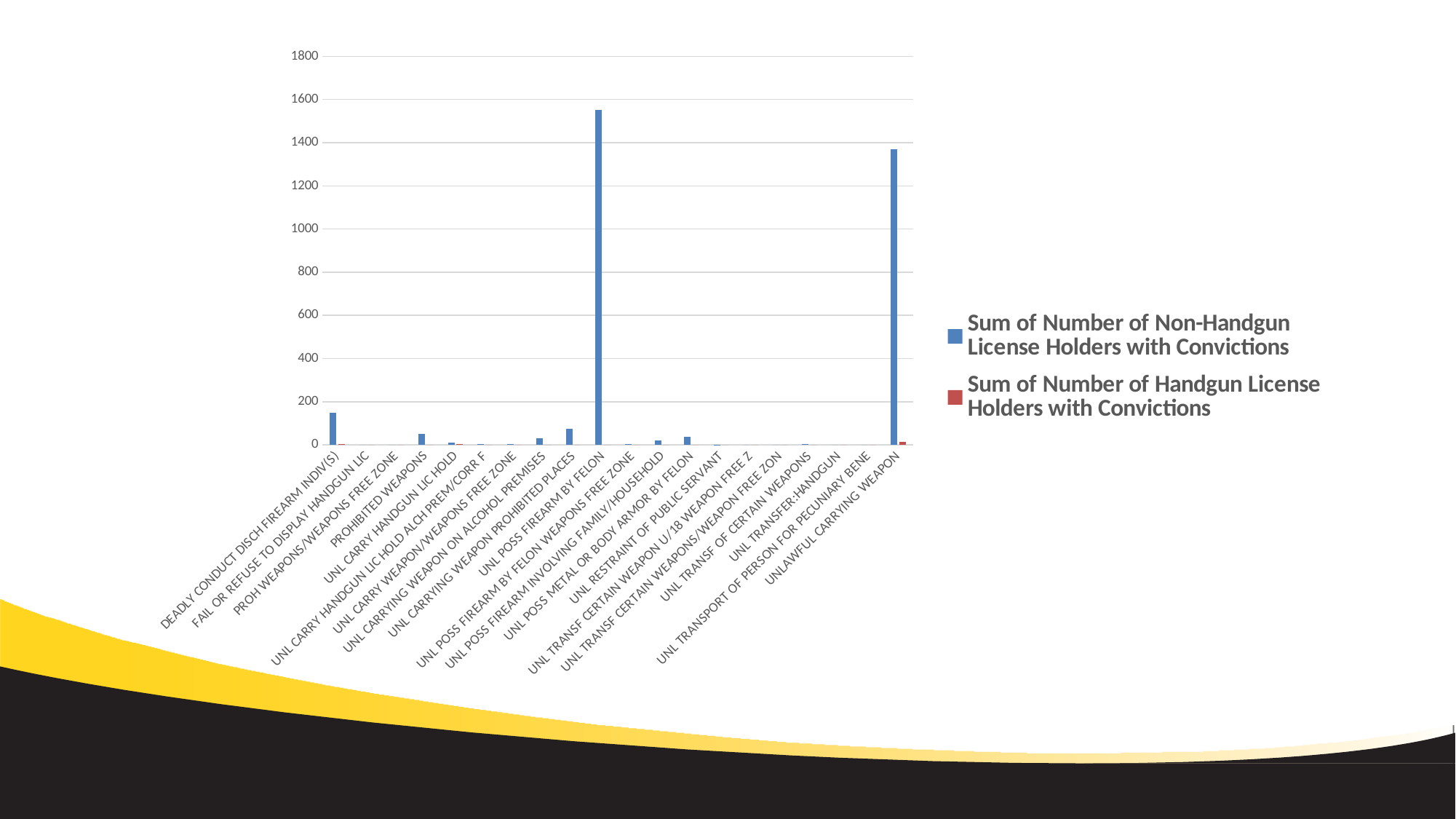
Is the value for UNLAWFUL CARRYING WEAPON in the Non-Handgun License Holders series greater or less than 1200? greater What kind of chart is shown on the slide? bar chart How many categories are shown on the x axis? 20 Which is larger for Non-Handgun License Holders with Convictions: DEADLY CONDUCT DISCH FIREARM INDIV(S) or PROHIBITED WEAPONS? DEADLY CONDUCT DISCH FIREARM INDIV(S) Which category has the highest value for Sum of Number of Non-Handgun License Holders with Convictions? UNL POSS FIREARM BY FELON How many series does the legend list? 2 Is the value for UNLAWFUL CARRYING WEAPON in the Non-Handgun License Holders series greater or less than 1400? less Is the value for UNL POSS FIREARM BY FELON in the Non-Handgun License Holders series greater or less than 1400? greater What colour represents Sum of Number of Handgun License Holders with Convictions in the legend? red Which is larger for Non-Handgun License Holders with Convictions: UNL POSS FIREARM BY FELON or UNLAWFUL CARRYING WEAPON? UNL POSS FIREARM BY FELON What is the highest value shown on the vertical axis? 1800